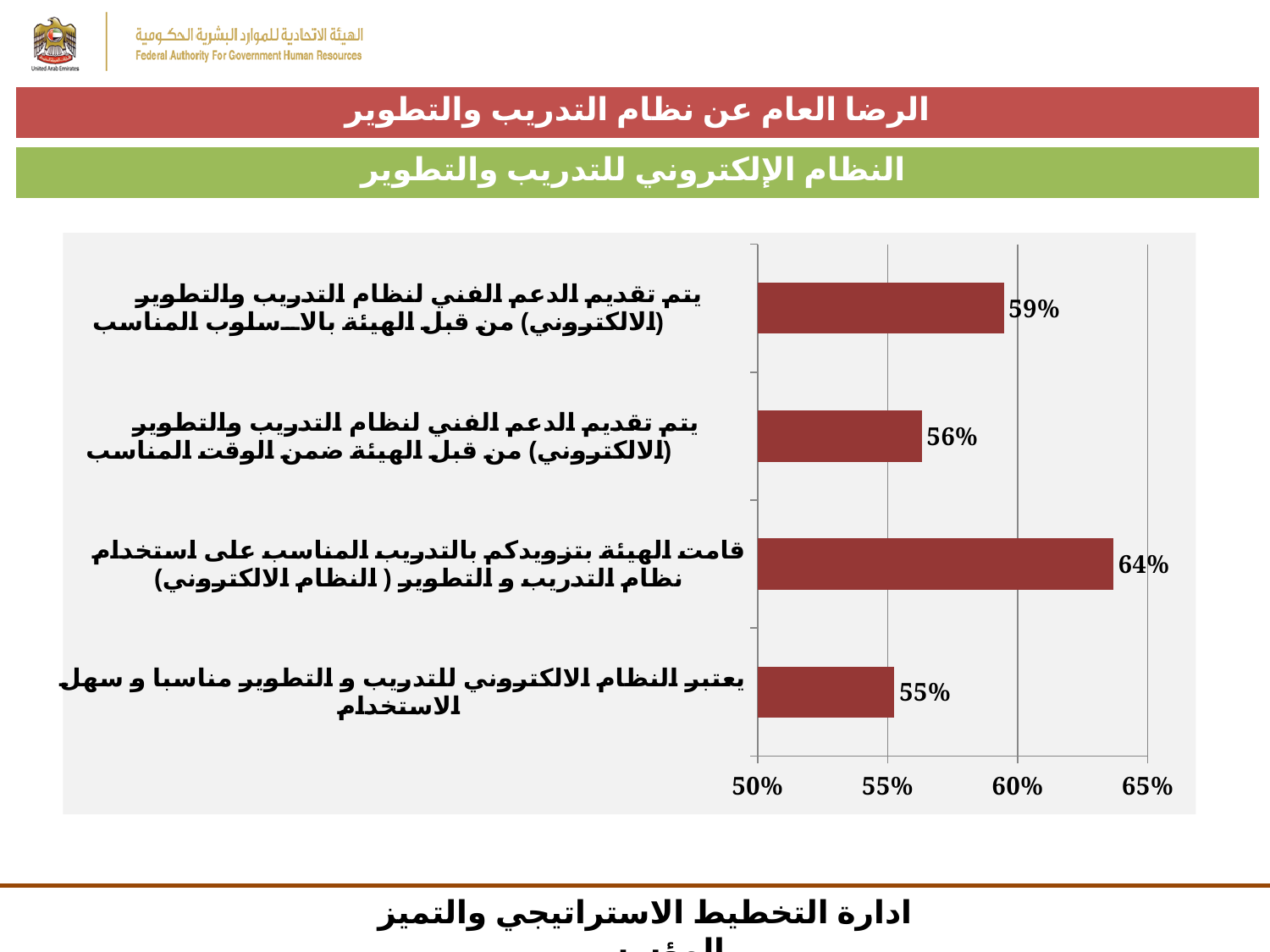
What is the value for the topmost bar, "يتم تقديم الدعم الفني لنظام التدريب والتطوير (الالكتروني) من قبل الهيئة بالاسلوب المناسب"? 59% What is the difference between the highest value (64%) and the lowest value (55%)? 9% Which is larger: the value for "يتم تقديم الدعم الفني ... بالاسلوب المناسب" or the value for "يتم تقديم الدعم الفني ... ضمن الوقت المناسب"? يتم تقديم الدعم الفني ... بالاسلوب المناسب What is the difference between the value for "بالاسلوب المناسب" (59%) and the value for "ضمن الوقت المناسب" (56%)? 3% Is the value for "قامت الهيئة بتزويدكم بالتدريب المناسب ..." greater or less than 60%? greater Which category has the lowest value? يعتبر النظام الالكتروني للتدريب و التطوير مناسبا و سهل الاستخدام What kind of chart is shown on the slide? bar chart Which category has the highest value? قامت الهيئة بتزويدكم بالتدريب المناسب على استخدام نظام التدريب و التطوير (النظام الالكتروني) What is the value for the category "يعتبر النظام الالكتروني للتدريب و التطوير مناسبا و سهل الاستخدام"? 55% How many categories are shown in the chart? 4 What is the value for the category "يتم تقديم الدعم الفني لنظام التدريب والتطوير (الالكتروني) من قبل الهيئة ضمن الوقت المناسب"? 56% What is the value for the category "قامت الهيئة بتزويدكم بالتدريب المناسب على استخدام نظام التدريب و التطوير (النظام الالكتروني)"? 64%